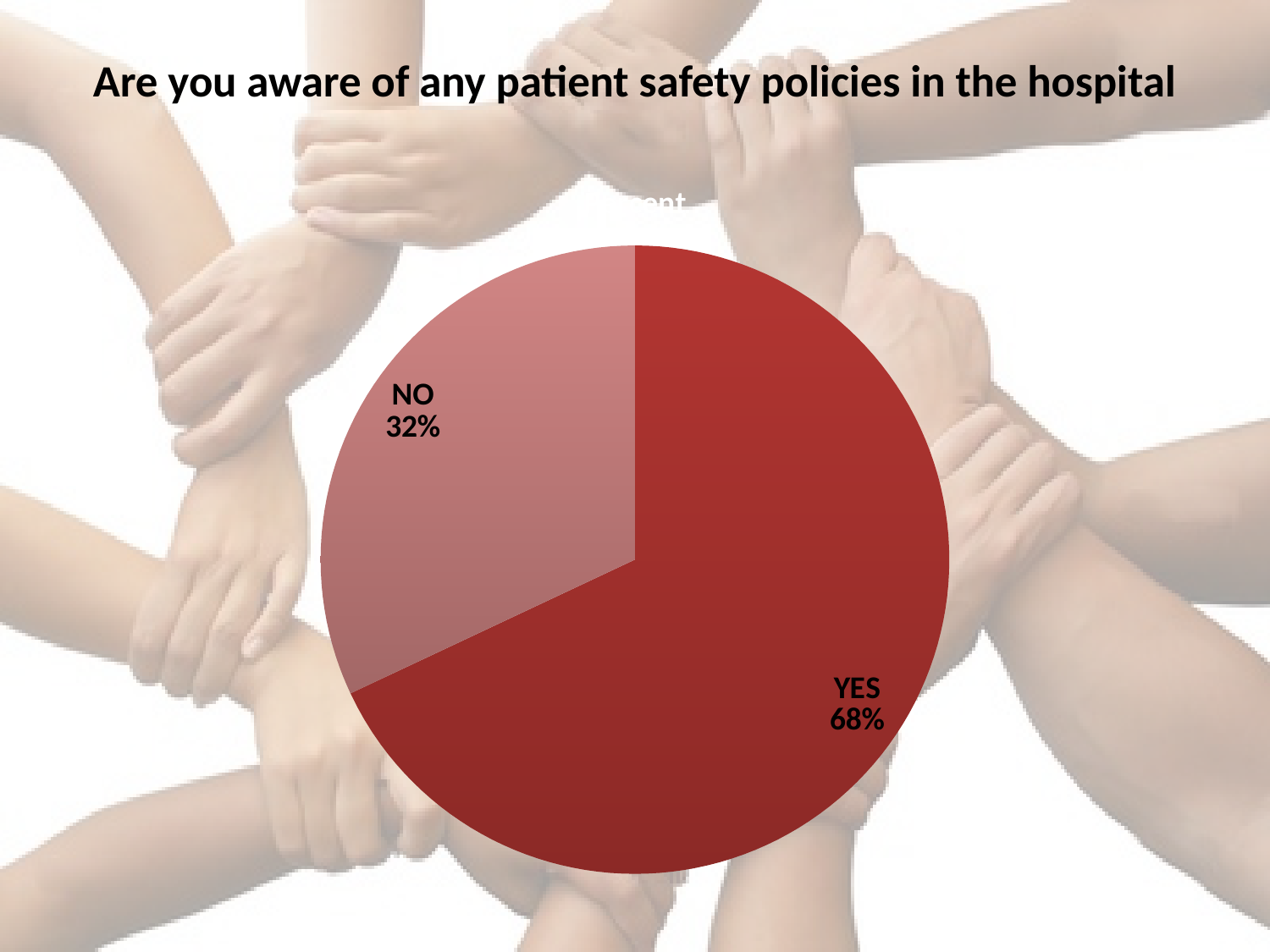
Which response has the smallest share of the pie? NO What question does the chart title ask? Are you aware of any patient safety policies in the hospital What share of the pie does the NO slice represent? 32% What kind of chart is shown on the slide? pie chart Which slice is drawn in the darker red colour? YES Which slice is larger, YES or NO? YES How many slices does the pie chart have? 2 Which response has the largest share of the pie? YES What percentage of respondents answered NO? 32% What is the difference in percentage points between the YES and NO slices? 36 What percentage of respondents answered YES? 68%